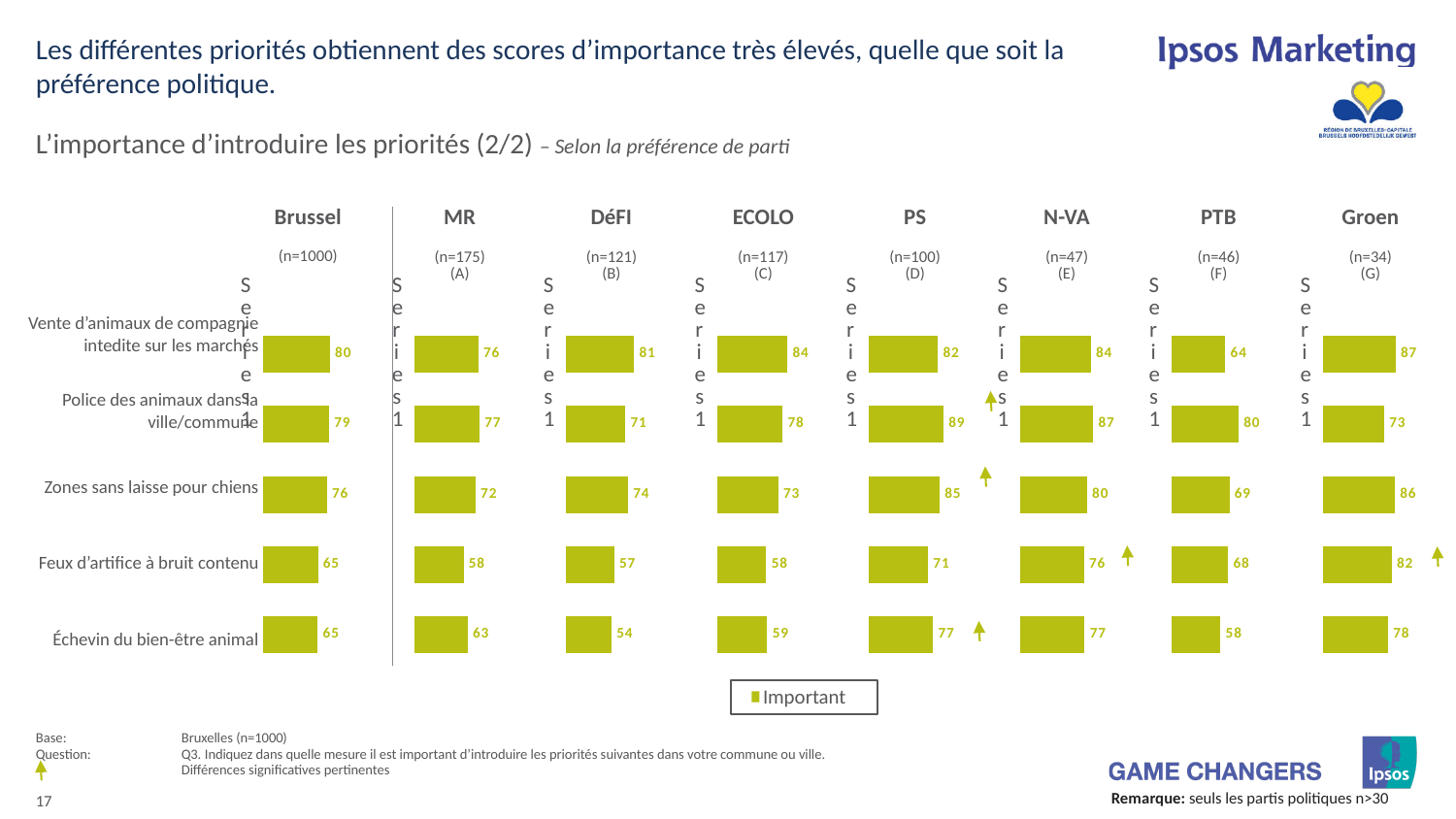
What is the sample size (n) shown for the PTB chart? n=46 What type of chart is used for the MR data? bar chart In the MR chart, which is larger: the value for Zones sans laisse pour chiens or the value for Feux d'artifice à bruit contenu? Zones sans laisse pour chiens In the PTB chart, which category has the lowest value? Échevin du bien-être animal How many categories are shown in the Brussel chart? 5 In the Brussel chart, what is the value for Vente d'animaux de compagnie interdite sur les marchés? 80 In the ECOLO chart, what is the value for Zones sans laisse pour chiens? 73 In the DéFI chart, what is the difference between the values for Vente d'animaux de compagnie interdite sur les marchés and Échevin du bien-être animal? 27 In the N-VA chart, which category has the highest value? Police des animaux dans la ville/commune How many series does the legend at the bottom of the slide list? 1 In the Groen chart, what is the value for Feux d'artifice à bruit contenu? 82 In the PS chart, what is the value for Police des animaux dans la ville/commune? 89